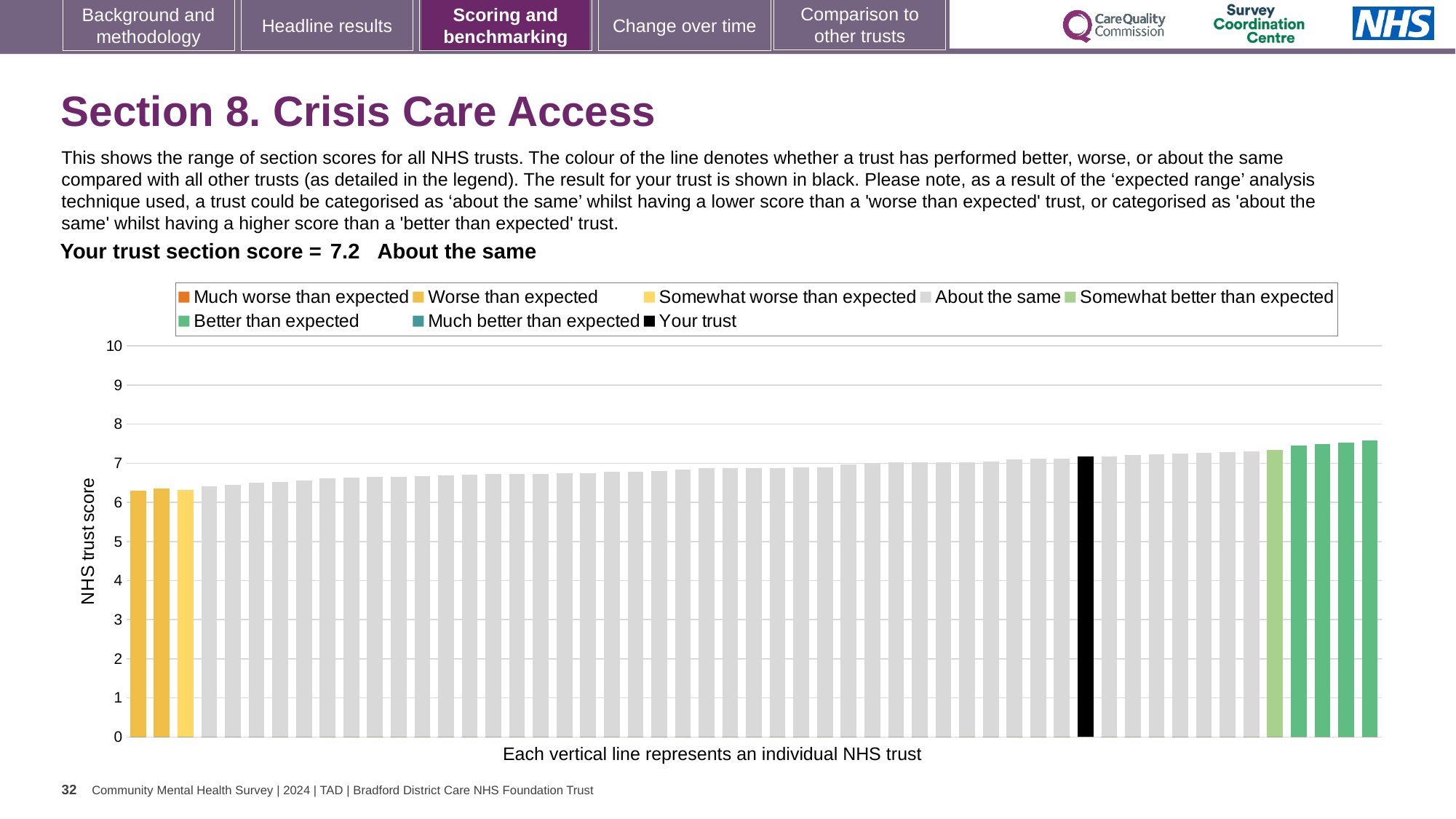
What is the label on the vertical axis of the chart? NHS trust score How many bars are coloured as 'Worse than expected' (dark yellow)? 2 Is the value of the tallest bar in the chart greater or less than 8? less Which is larger, the leftmost bar or the rightmost bar? the rightmost bar Which performance category is your trust placed in for this section? About the same Is the value of the leftmost bar in the chart greater or less than 6? greater Do the bar values rise or fall from left to right along the x axis? rise Is the value of the black 'Your trust' bar greater or less than 7? greater How many entries does the chart legend list? 8 What is the section score for your trust shown on the slide? 7.2 How many bars are coloured as 'Better than expected' (green)? 4 What kind of chart is shown on the slide? bar chart